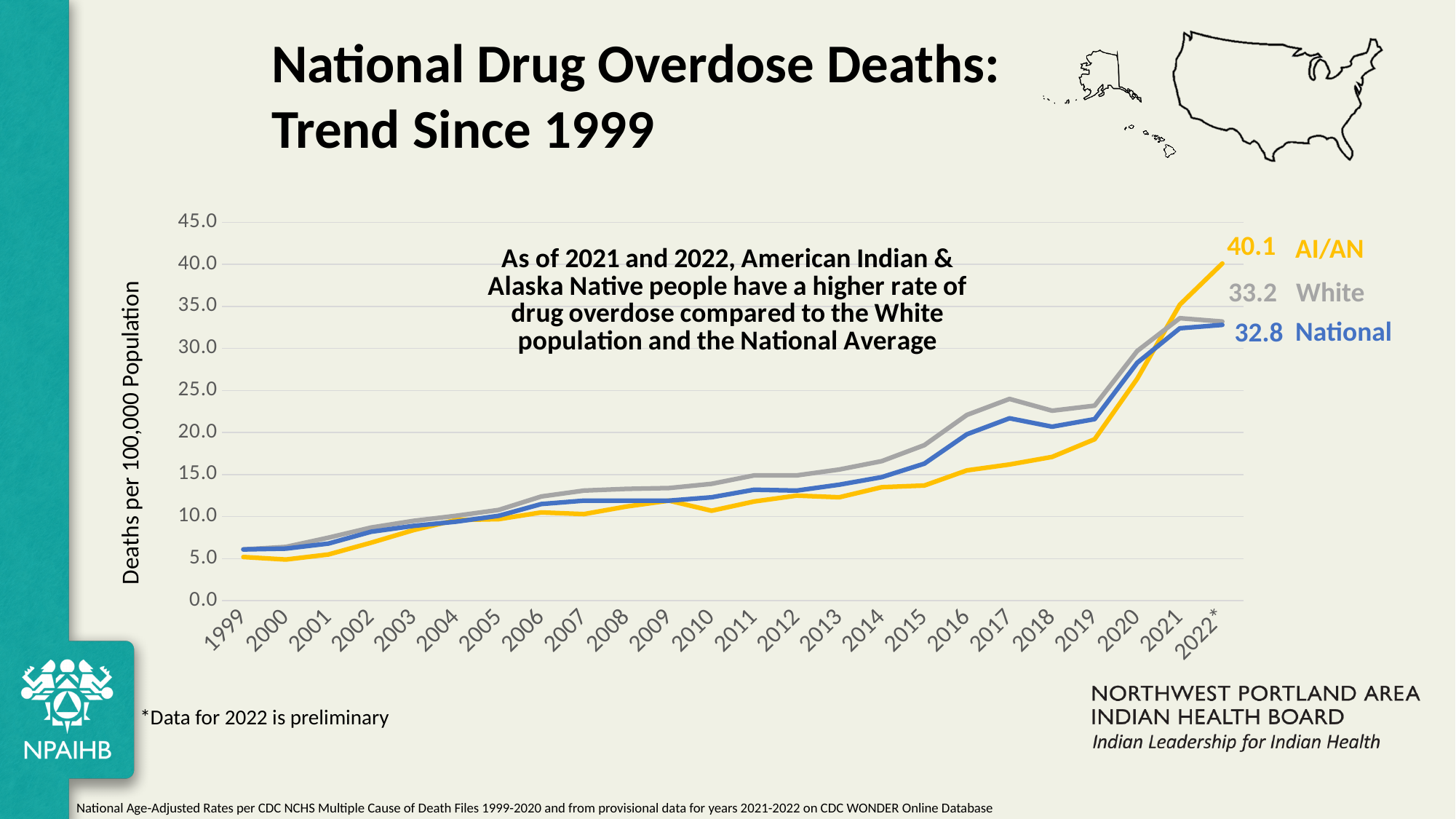
What kind of chart is shown on the slide? line chart What is the National value shown for 2022*? 32.8 Is the White value for 2017 greater or less than 20.0? greater What is the difference between the AI/AN and National values in 2022*? 7.3 What is the AI/AN value shown for 2022*? 40.1 Which series has the lowest value in 2022*? National Which series has the highest value in 2022*? AI/AN Is the AI/AN value for 1999 greater or less than 10.0? less What is the White value shown for 2022*? 33.2 Do the values generally rise or fall from 1999 to 2022*? rise How many series does the chart show? 3 What is the difference between the AI/AN and White values in 2022*? 6.9